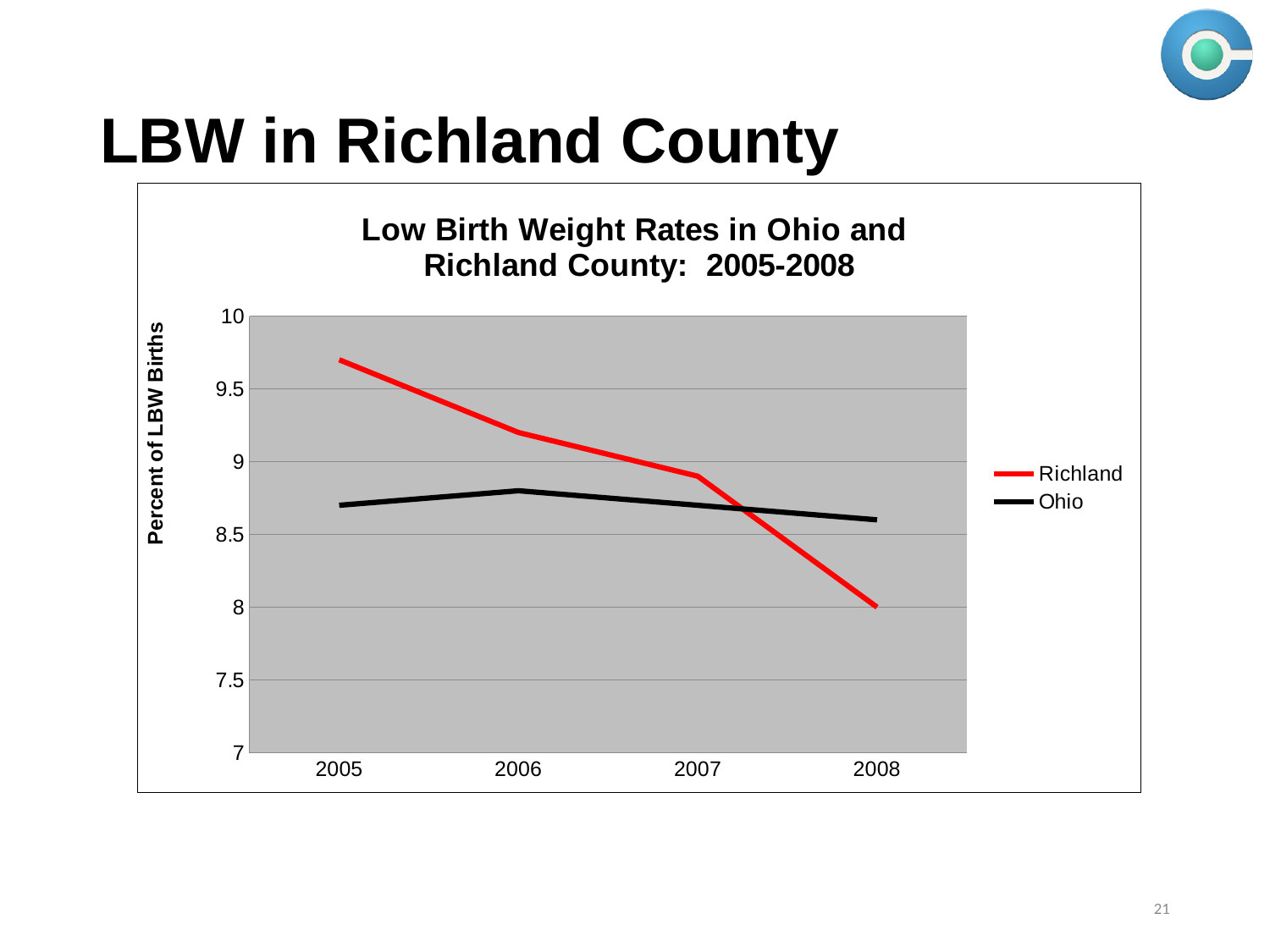
Is the Richland value for 2006 greater or less than 9? greater What is the label on the y axis of the chart? Percent of LBW Births Which series has the higher value in 2005, Richland or Ohio? Richland In which year is the Richland value highest? 2005 What kind of chart is shown on the slide? line chart Is the Richland value for 2005 greater or less than 9.5? greater Which series has the higher value in 2008, Richland or Ohio? Ohio Is the Ohio value for 2008 greater or less than 9? less Does the Richland line rise or fall from 2005 to 2008? fall How many series does the legend list? 2 How many years are plotted along the x axis? 4 In which year is the Richland value lowest? 2008